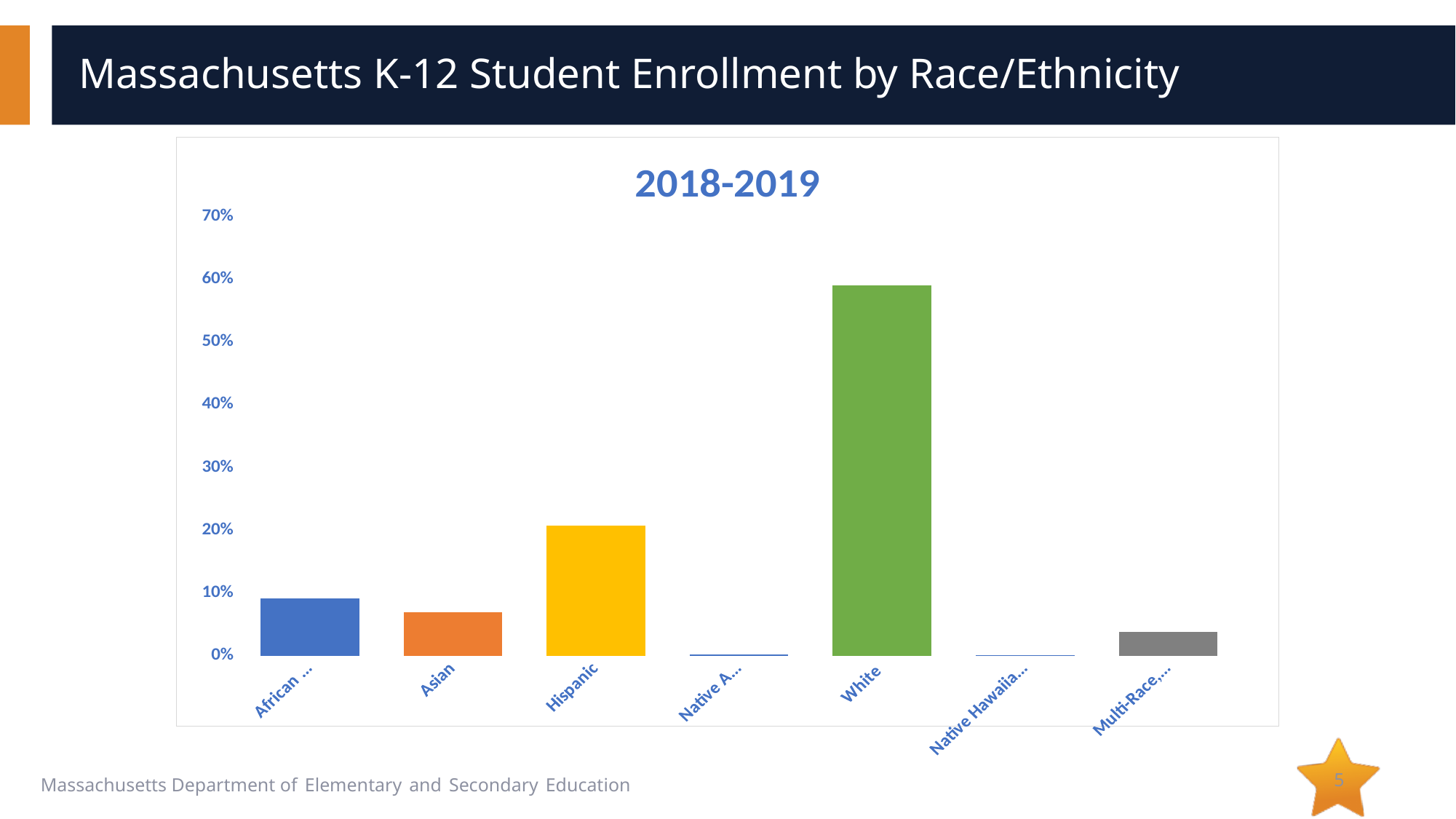
Is the value for Hispanic greater or less than 30%? less Is the value for Asian greater or less than 10%? less Which is larger, the value for White or the value for Hispanic? White Which category has the highest enrollment share? White What is the title of the chart? 2018-2019 What kind of chart is shown on the slide? Bar chart Which is larger, the value for Asian or the value for Multi-Race? Asian Which is larger, the value for Hispanic or the value for Asian? Hispanic Is the value for White greater or less than 50%? greater How many categories (bars) are shown on the chart? 7 What colour is the bar for White? Green